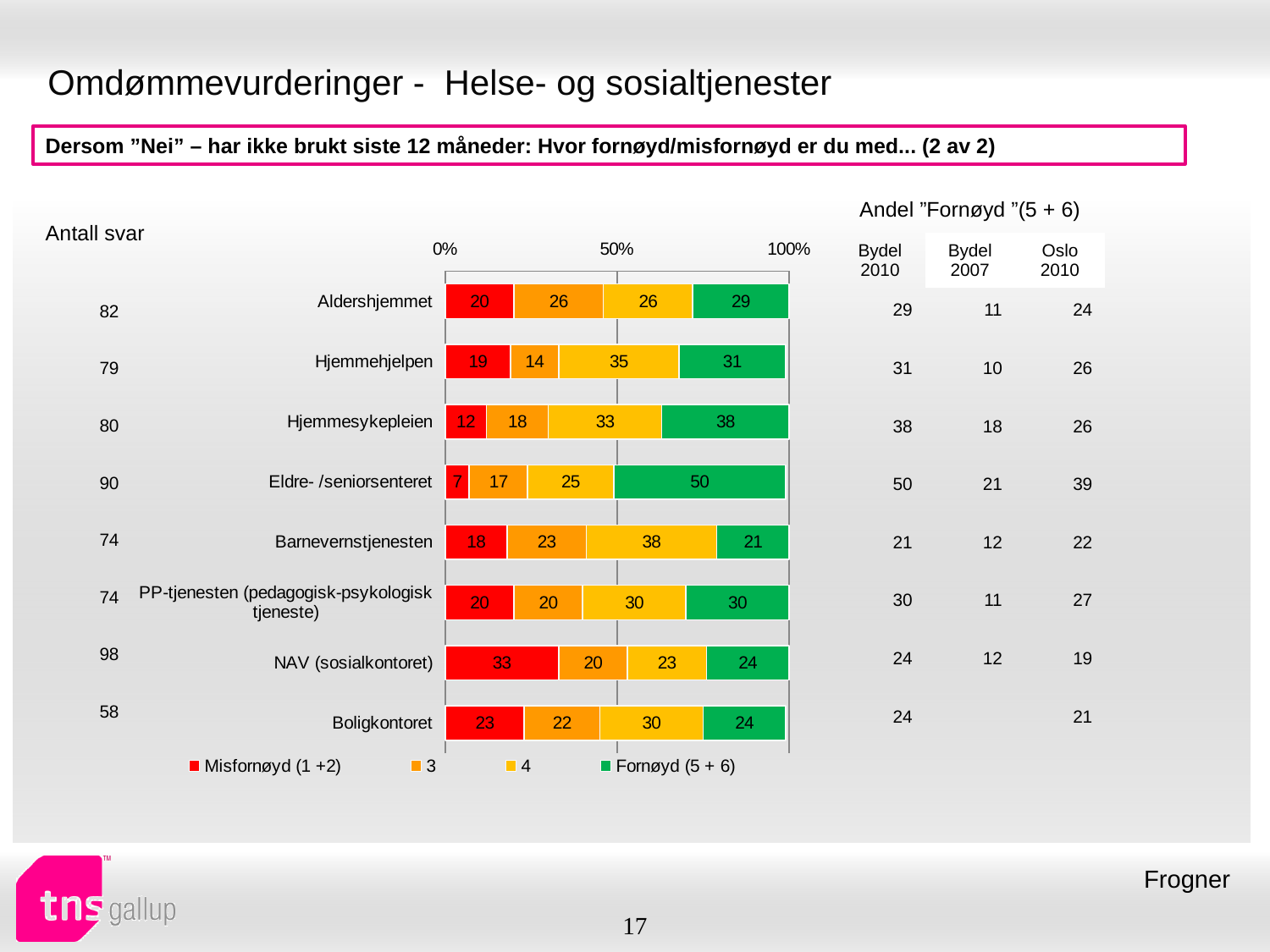
What is the difference between the "Fornøyd (5 + 6)" values for Hjemmesykepleien and Barnevernstjenesten? 17 Which is larger: the "Misfornøyd (1 +2)" value for NAV (sosialkontoret) or for Boligkontoret? NAV (sosialkontoret) How many series does the legend list? 4 Which legend entry is shown in green? Fornøyd (5 + 6) What is the total of the stacked bar for Barnevernstjenesten? 100 How many categories are shown in the bar chart? 8 What is the value of the "Fornøyd (5 + 6)" segment for Eldre- /seniorsenteret? 50 What is the value of the "Misfornøyd (1 +2)" segment for NAV (sosialkontoret)? 33 What kind of chart is shown on the slide? Stacked bar chart Which category has the lowest "Misfornøyd (1 +2)" value? Eldre- /seniorsenteret What is the value of the "4" segment for Hjemmehjelpen? 35 Which category has the highest "Fornøyd (5 + 6)" value? Eldre- /seniorsenteret